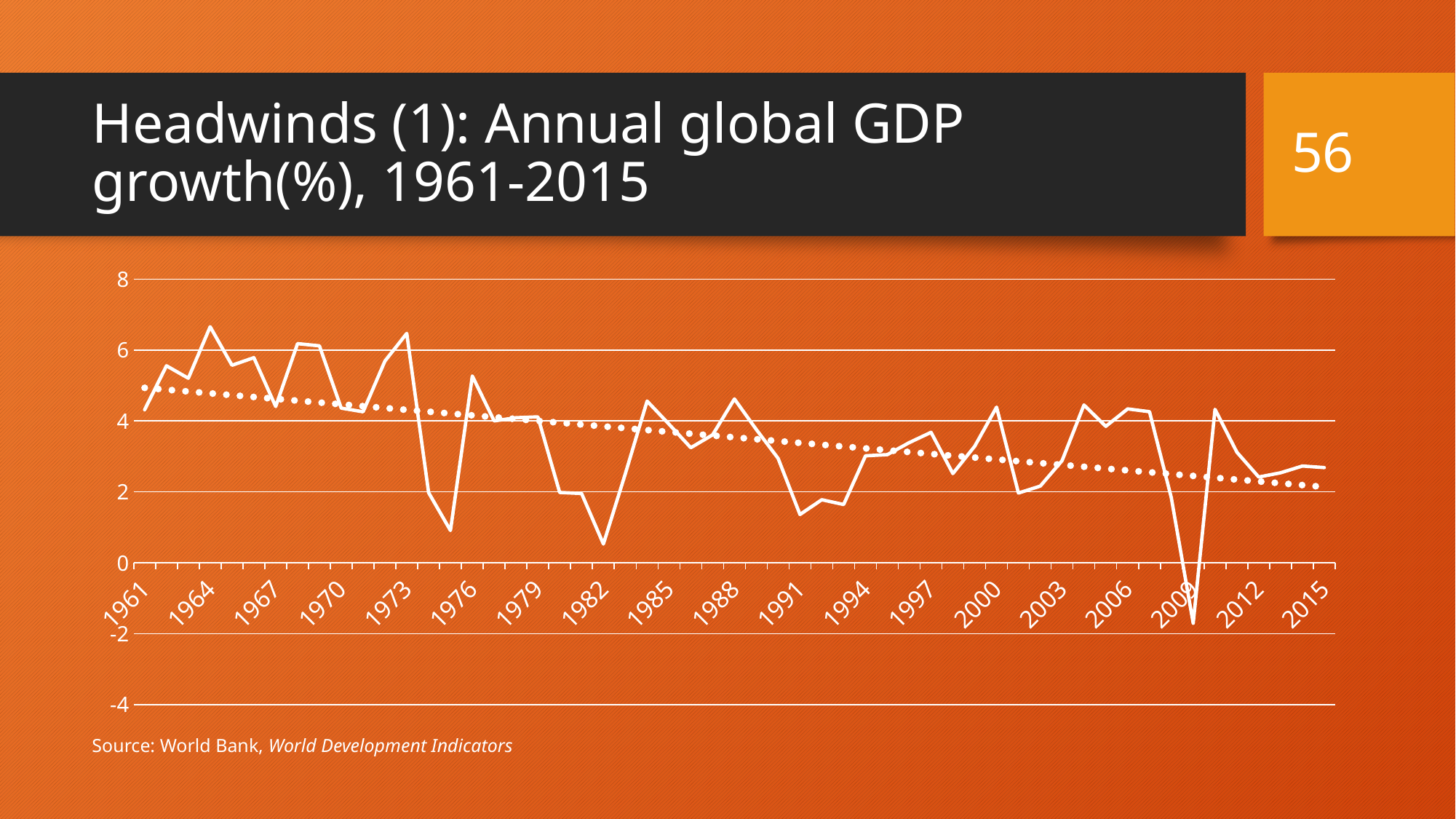
Is the value for 2009 greater or less than 0? less Is the value for 2001 greater or less than 4? less Does the dotted trend line rise or fall from 1961 to 2015? fall How many year labels are shown on the x axis? 19 Is the value for 1964 greater or less than 6? greater What kind of chart is shown on the slide? line chart Which year shows the lowest global GDP growth on the chart? 2009 What is the title of the slide's chart? Headwinds (1): Annual global GDP growth(%), 1961-2015 What is the source cited for the chart? World Bank, World Development Indicators